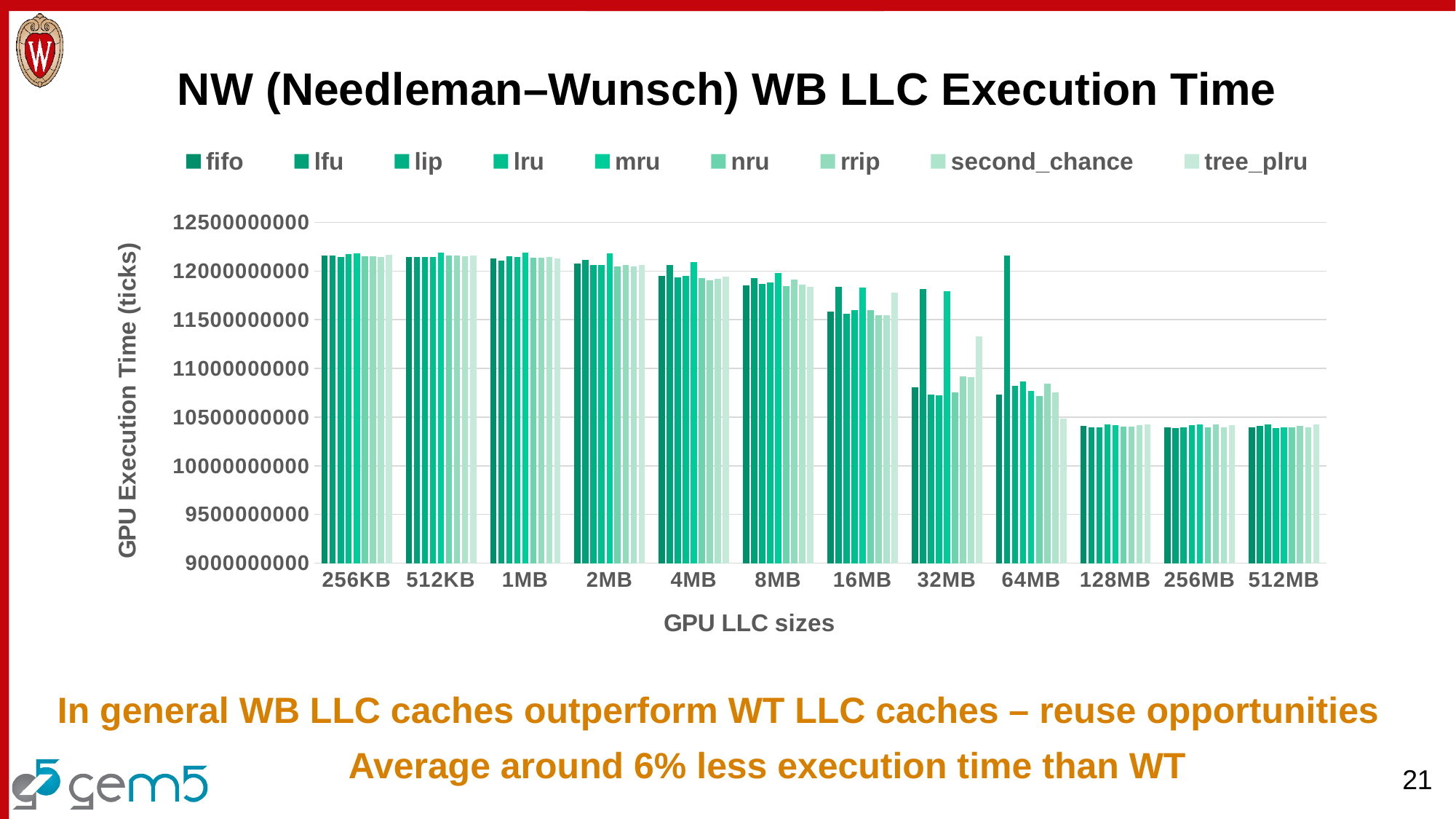
Is the lip value for 64MB greater or less than 12000000000? less What is the title of the chart? NW (Needleman–Wunsch) WB LLC Execution Time How many GPU LLC size categories are shown on the x axis? 12 Is the fifo value for 256KB greater or less than 12000000000? greater What is the label of the y axis? GPU Execution Time (ticks) Do the execution time values generally rise or fall as the GPU LLC size increases from 256KB to 512MB? fall Which series has the highest value at 64MB? lfu What kind of chart is shown on the slide? bar chart Is the fifo value for 128MB greater or less than 10500000000? less Which is larger, the fifo value for 256KB or the fifo value for 512MB? 256KB How many series does the legend list? 9